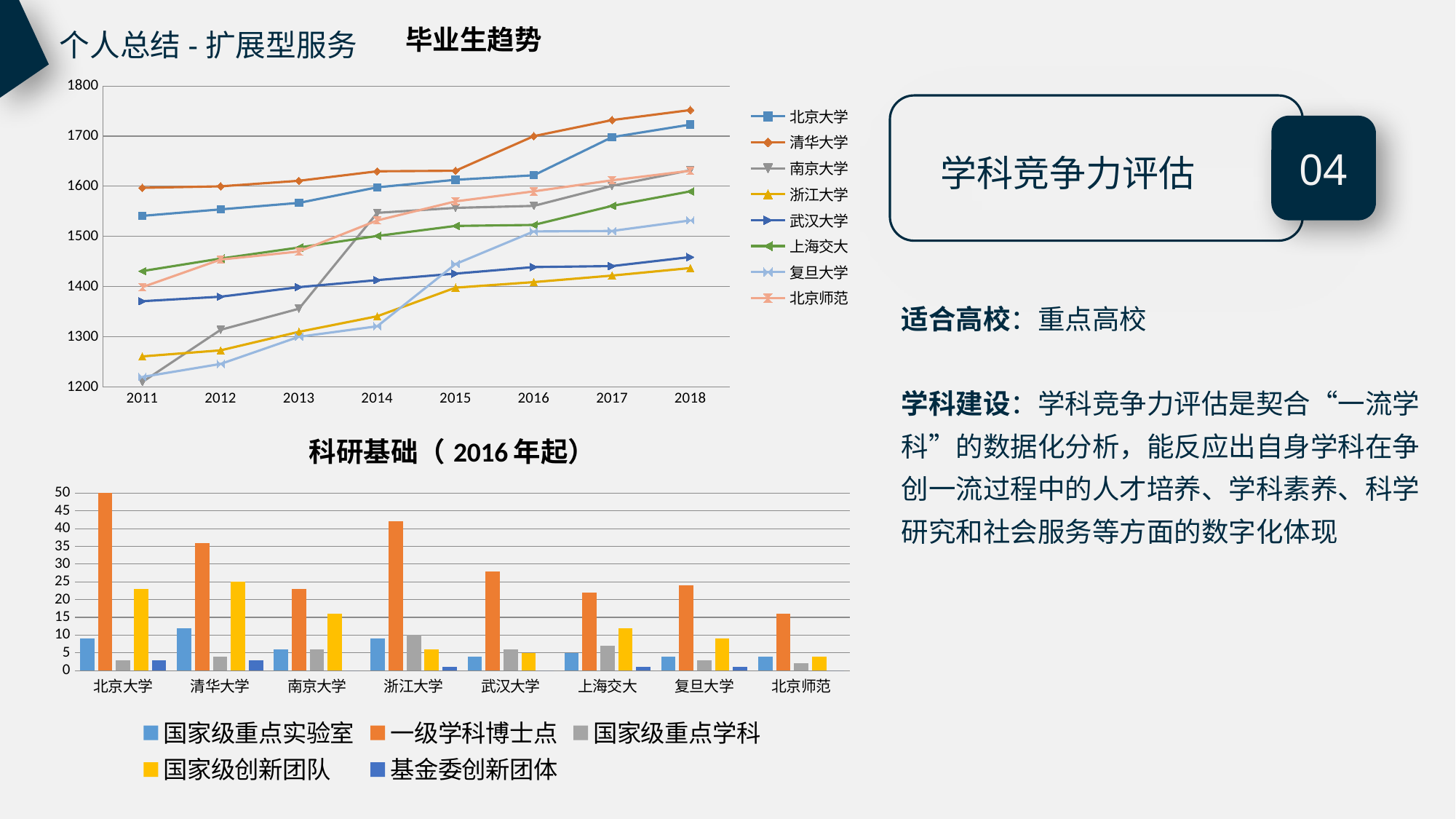
In the 科研基础（2016年起） chart, what is the value of 一级学科博士点 for 北京大学? 50 In the 毕业生趋势 chart, is the value for 浙江大学 in 2011 greater or less than 1300? less In the 科研基础（2016年起） chart, which is larger: 一级学科博士点 for 清华大学 or for 北京师范? 清华大学 What kind of chart is the 毕业生趋势 chart at the top of the slide? line chart In the 科研基础（2016年起） chart, how many series does the legend list? 5 In the 科研基础（2016年起） chart, which university has the highest value for 一级学科博士点? 北京大学 In the 毕业生趋势 chart, how many years are shown on the x axis? 8 In the 毕业生趋势 chart, which university has the highest value in 2018? 清华大学 In the 毕业生趋势 chart, how many series does the legend list? 8 In the 毕业生趋势 chart, does the value for 清华大学 rise or fall from 2011 to 2018? rise In the 科研基础（2016年起） chart, is the value of 一级学科博士点 for 浙江大学 greater or less than 40? greater What kind of chart is the 科研基础（2016年起） chart at the bottom of the slide? bar chart